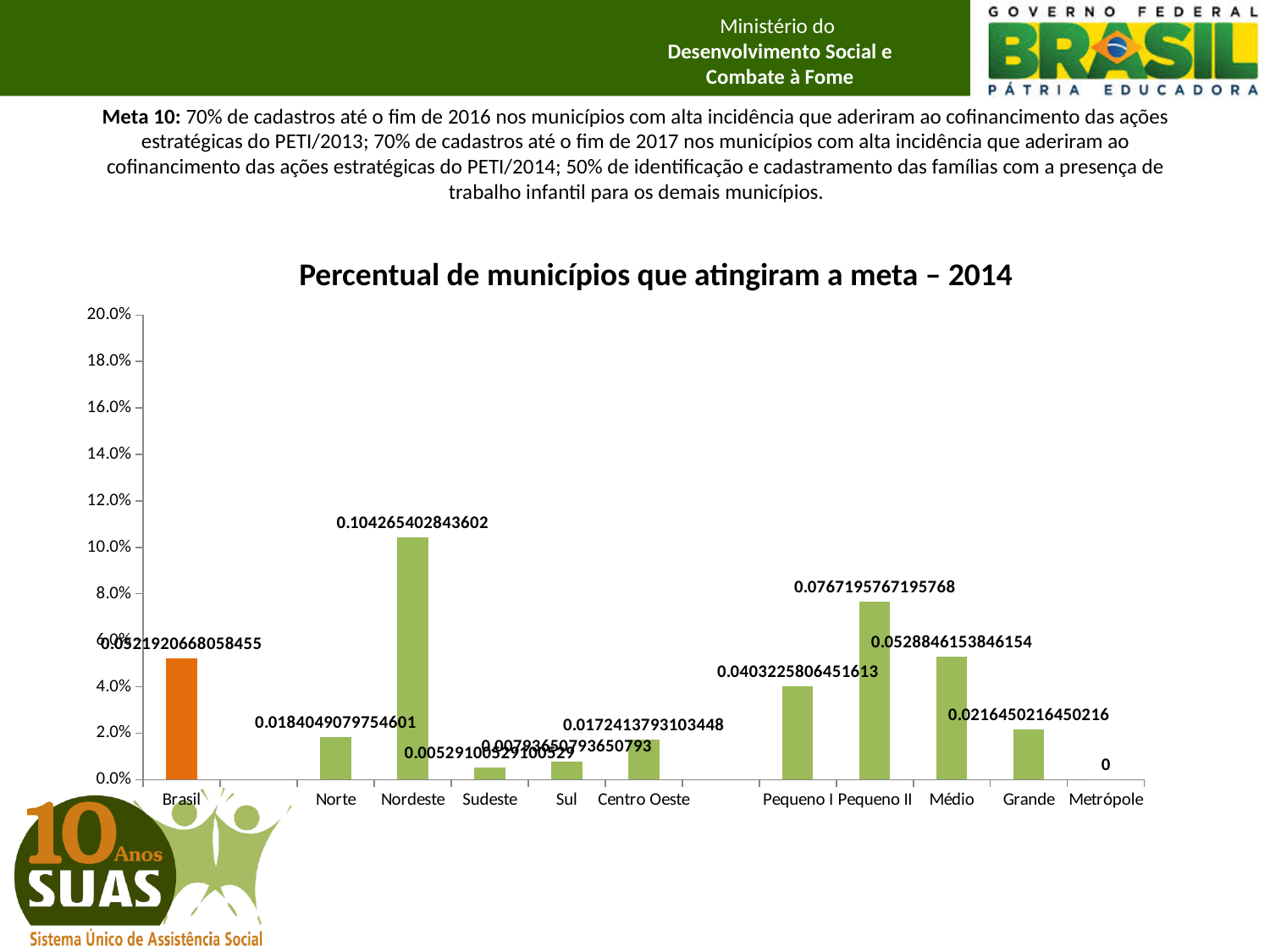
Is the value for Brasil greater or less than 4.0%? greater What is the data label value for Pequeno II? 0.0767195767195768 What is the data label value for Metrópole? 0 What kind of chart is shown on the slide? bar chart How many categories are plotted on the x axis of the chart? 11 Which category has the lowest value in the chart? Metrópole What is the data label value for Médio? 0.0528846153846154 What is the data label value for Grande? 0.0216450216450216 Which is larger, the value for Pequeno I or the value for Pequeno II? Pequeno II What is the data label value for Nordeste? 0.104265402843602 What is the title of the chart? Percentual de municípios que atingiram a meta – 2014 Which category has the highest value in the chart? Nordeste